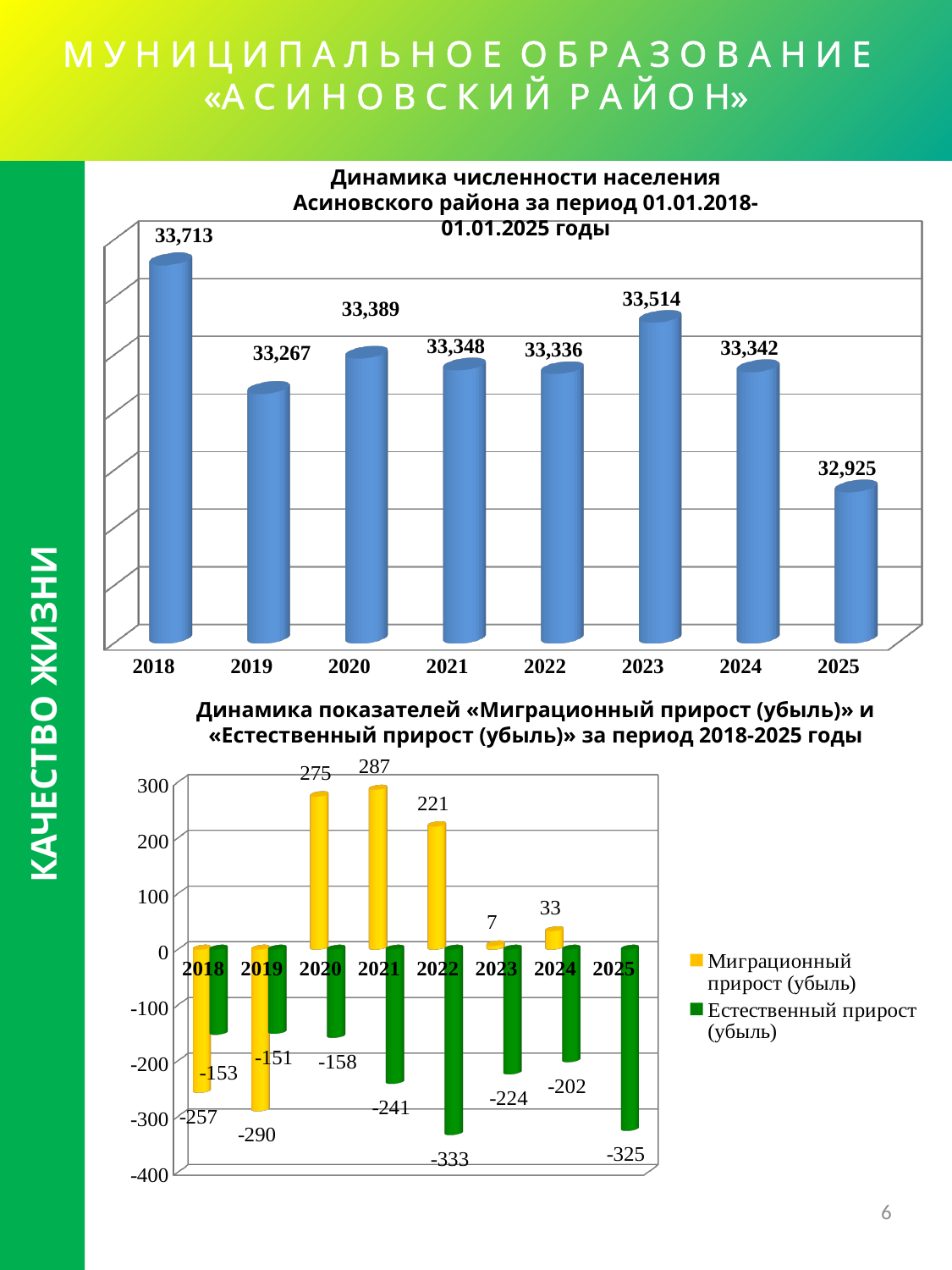
In the bottom chart (Динамика показателей), what is the value of Миграционный прирост (убыль) for 2021? 287 In the top chart (Динамика численности населения), how many years are shown? 8 In the bottom chart (Динамика показателей), what is the value of Естественный прирост (убыль) for 2022? -333 In the top chart (Динамика численности населения), which year has the lowest population? 2025 In the top chart (Динамика численности населения), what is the population value for 2025? 32,925 In the top chart (Динамика численности населения), what is the population value for 2018? 33,713 In the top chart (Динамика численности населения), which year has the highest population? 2018 In the bottom chart (Динамика показателей), what is the difference between Естественный прирост (убыль) for 2023 and 2024? 22 What type of chart is the top chart (Динамика численности населения)? Bar chart In the bottom chart (Динамика показателей), which is larger: Миграционный прирост (убыль) for 2020 or for 2022? 2020 In the bottom chart (Динамика показателей), how many series does the legend list? 2 In the top chart (Динамика численности населения), what is the difference between the 2018 and 2025 values? 788